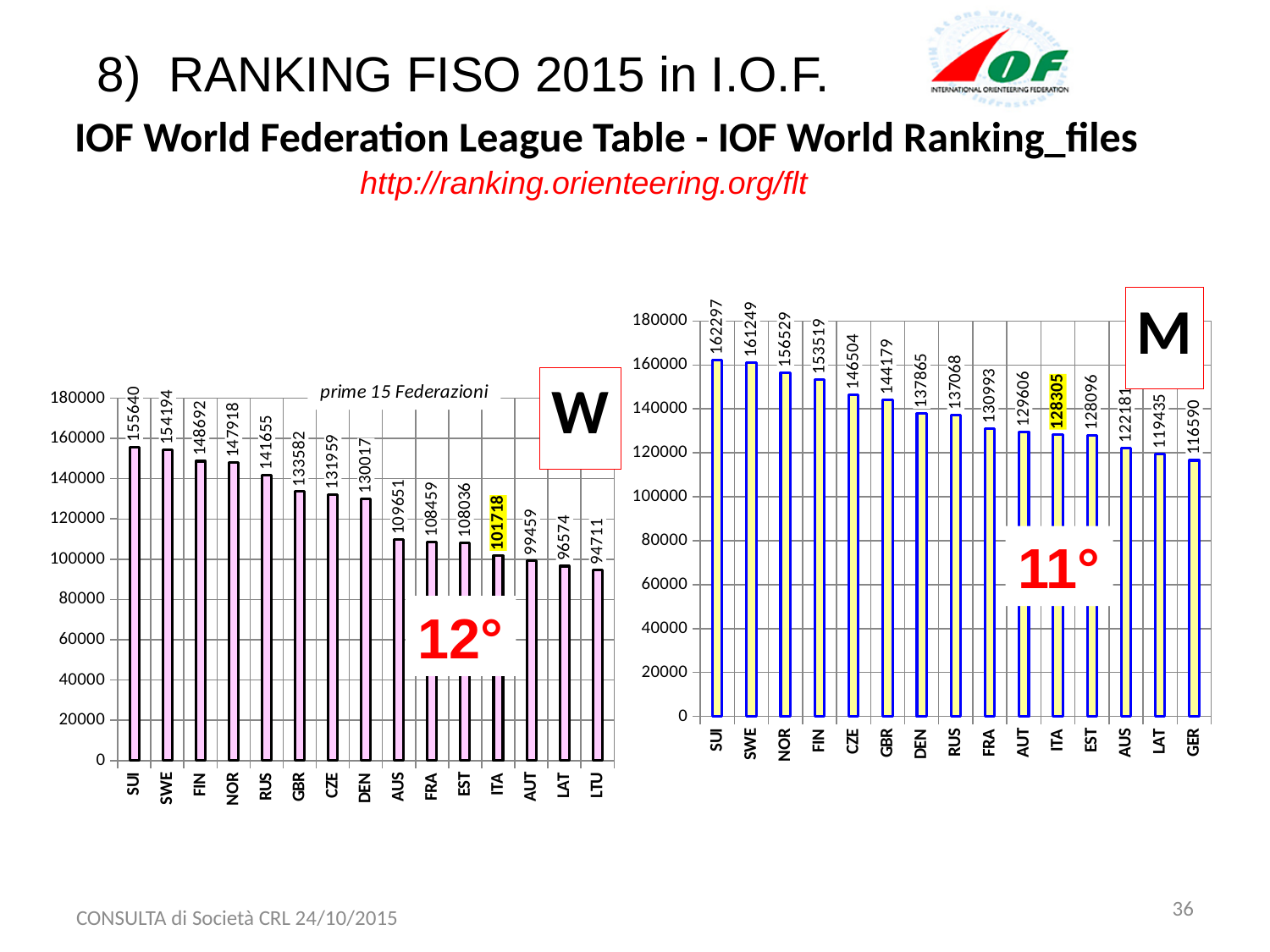
In the right chart (M), which federation has the lowest value? GER In the left chart (W), what is the value for GBR? 133582 How many federations are shown in the right chart (M)? 15 In the right chart (M), what is the value for ITA? 128305 In the left chart (W), what is the difference between the values for SUI and LTU? 60929 In the left chart (W), which federation has the highest value? SUI What kind of chart is the left chart (W)? bar chart In the right chart (M), what is the difference between the values for SUI and SWE? 1048 In the right chart (M), do the values rise or fall from left to right along the x axis? fall In the right chart (M), which is larger, the value for CZE or the value for DEN? CZE In the left chart (W), is the value for AUS greater or less than 120000? less In the left chart (W), what is the value for ITA? 101718